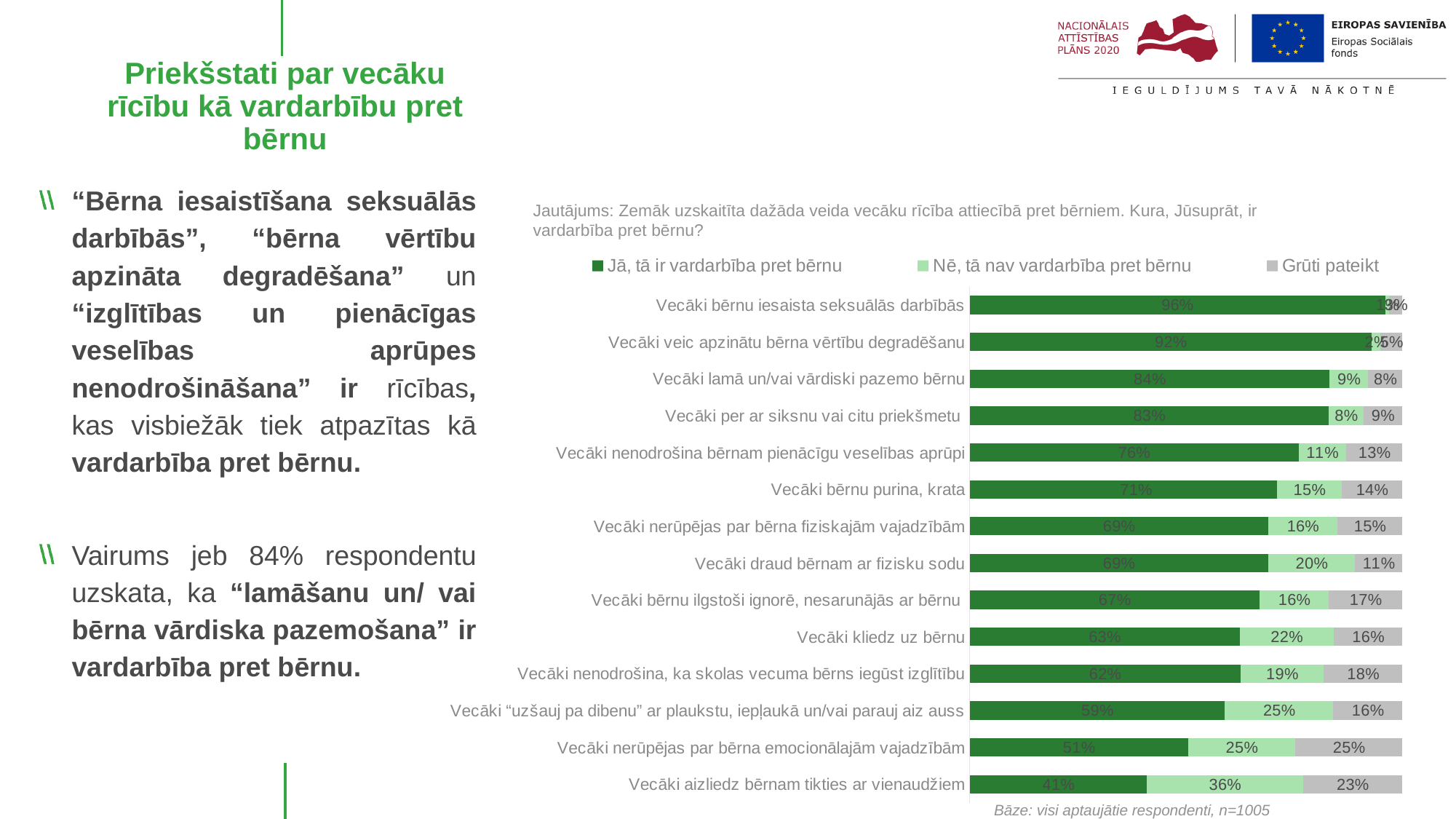
What type of chart is shown on the slide? Stacked bar chart How many categories (types of parental behaviour) are shown in the chart? 14 Which has a larger "Nē, tā nav vardarbība pret bērnu" value: "Vecāki kliedz uz bērnu" or "Vecāki bērnu purina, krata"? Vecāki kliedz uz bērnu What is the difference between the "Jā, tā ir vardarbība pret bērnu" values for "Vecāki kliedz uz bērnu" and "Vecāki aizliedz bērnam tikties ar vienaudžiem"? 22% What is the "Nē, tā nav vardarbība pret bērnu" value for "Vecāki aizliedz bērnam tikties ar vienaudžiem"? 36% How many series does the chart legend list? 3 Which category has the lowest "Jā, tā ir vardarbība pret bērnu" value? Vecāki aizliedz bērnam tikties ar vienaudžiem What is the base (sample size) stated below the chart? n=1005 Which category has the highest "Jā, tā ir vardarbība pret bērnu" value? Vecāki bērnu iesaista seksuālās darbībās What is the "Grūti pateikt" value for "Vecāki nerūpējas par bērna emocionālajām vajadzībām"? 25% What percentage of respondents said "Jā, tā ir vardarbība pret bērnu" for "Vecāki lamā un/vai vārdiski pazemo bērnu"? 84% What is the "Jā, tā ir vardarbība pret bērnu" value for "Vecāki nenodrošina bērnam pienācīgu veselības aprūpi"? 76%